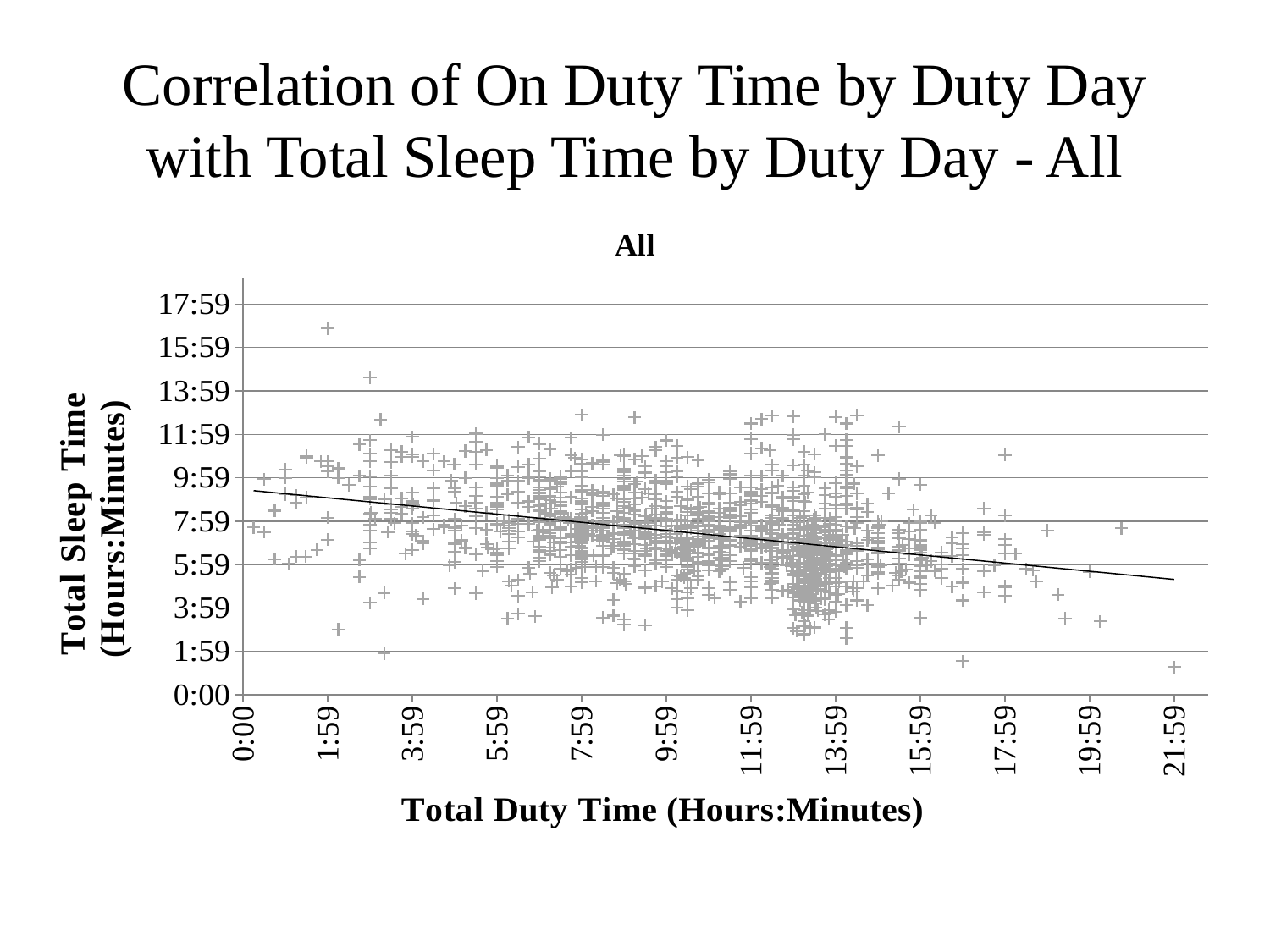
Is the trend line's Total Sleep Time at a Total Duty Time of 0:00 greater or less than 7:59? greater What is the label of the x axis of the chart? Total Duty Time (Hours:Minutes) What is the title shown directly above the chart? All Does the trend line in the chart rise or fall as Total Duty Time increases along the x axis? fall What kind of chart is shown on the slide? scatter chart Is the trend line's Total Sleep Time at a Total Duty Time of 21:59 greater or less than 5:59? less